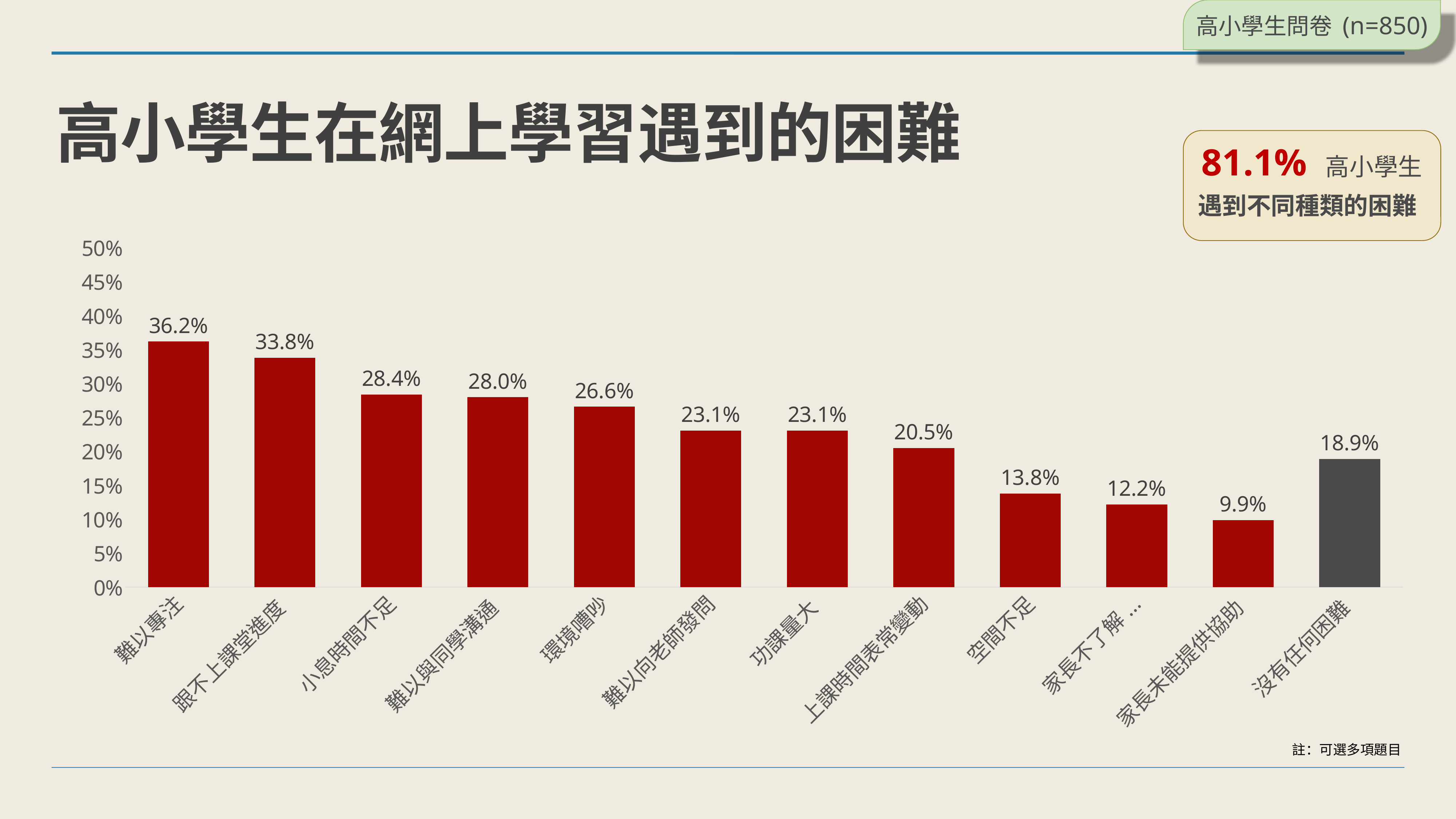
What is the value for 上課時間表常變動? 20.5% How many categories are shown on the x axis? 12 Which is larger, the value for 環境嘈吵 or the value for 空間不足? 環境嘈吵 What is the value for 難以專注? 36.2% Which category has the highest value? 難以專注 Which category has the lowest value? 家長未能提供協助 Which bar is shown in a different colour (grey) from the others? 沒有任何困難 What is the value for 沒有任何困難? 18.9% What is the value for 家長未能提供協助? 9.9% What kind of chart is shown on the slide? bar chart Is the value for 小息時間不足 greater or less than 25%? greater What is the difference between the values for 難以專注 and 跟不上課堂進度? 2.4%